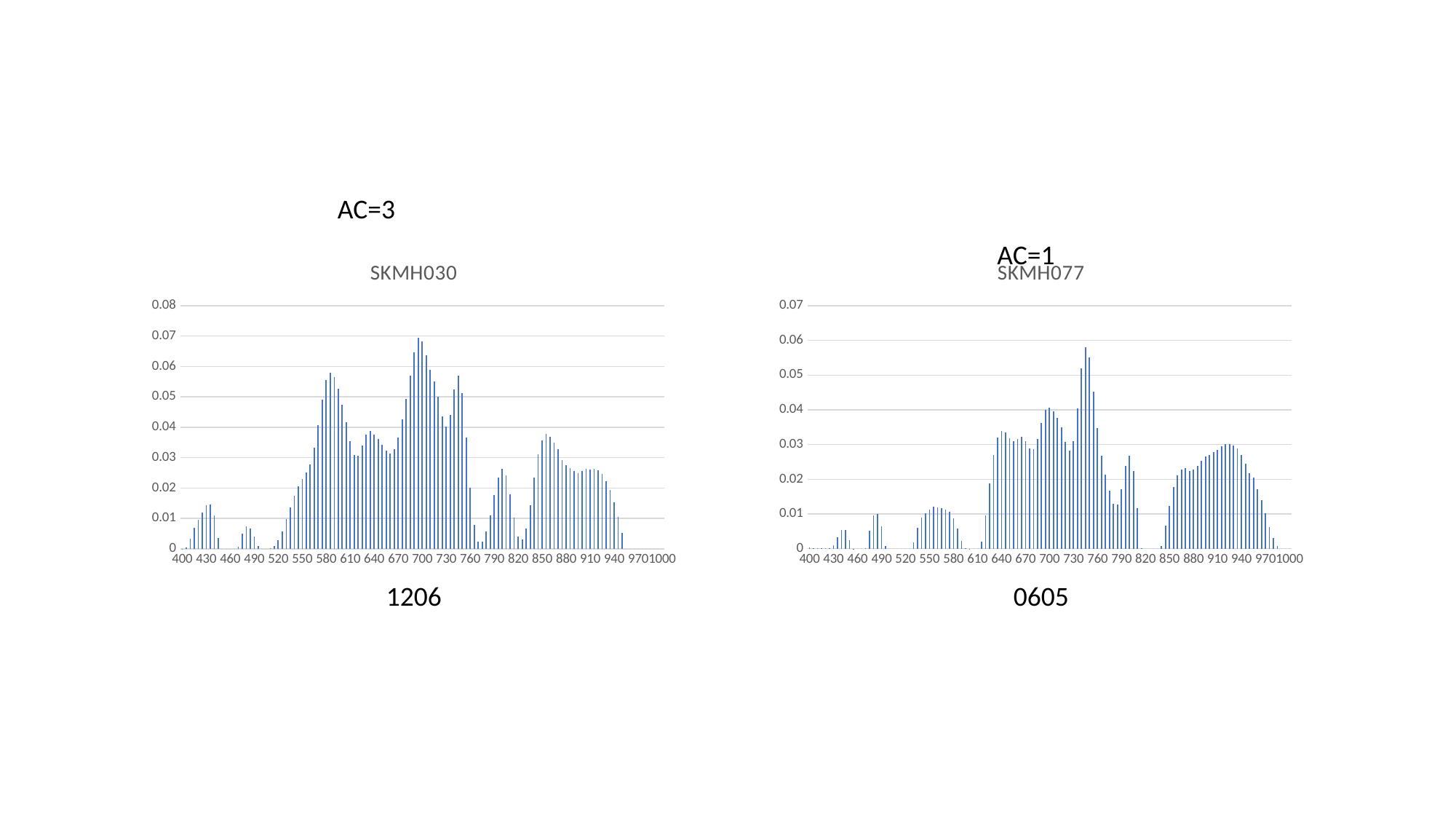
In the SKMH030 chart, is the value at 850 greater or less than 0.03? greater In the SKMH030 chart, is the value at 700 greater or less than 0.06? greater What is the title of the chart on the right? SKMH077 What kind of chart is the SKMH030 chart on the left? bar chart In the SKMH077 chart, which is larger: the value at 750 or the value at 490? 750 In the SKMH077 chart, is the value at 550 greater or less than 0.02? less In the SKMH030 chart, which is larger: the value at 700 or the value at 430? 700 What is the highest value shown on the y axis of the SKMH077 chart? 0.07 What is the highest value shown on the y axis of the SKMH030 chart? 0.08